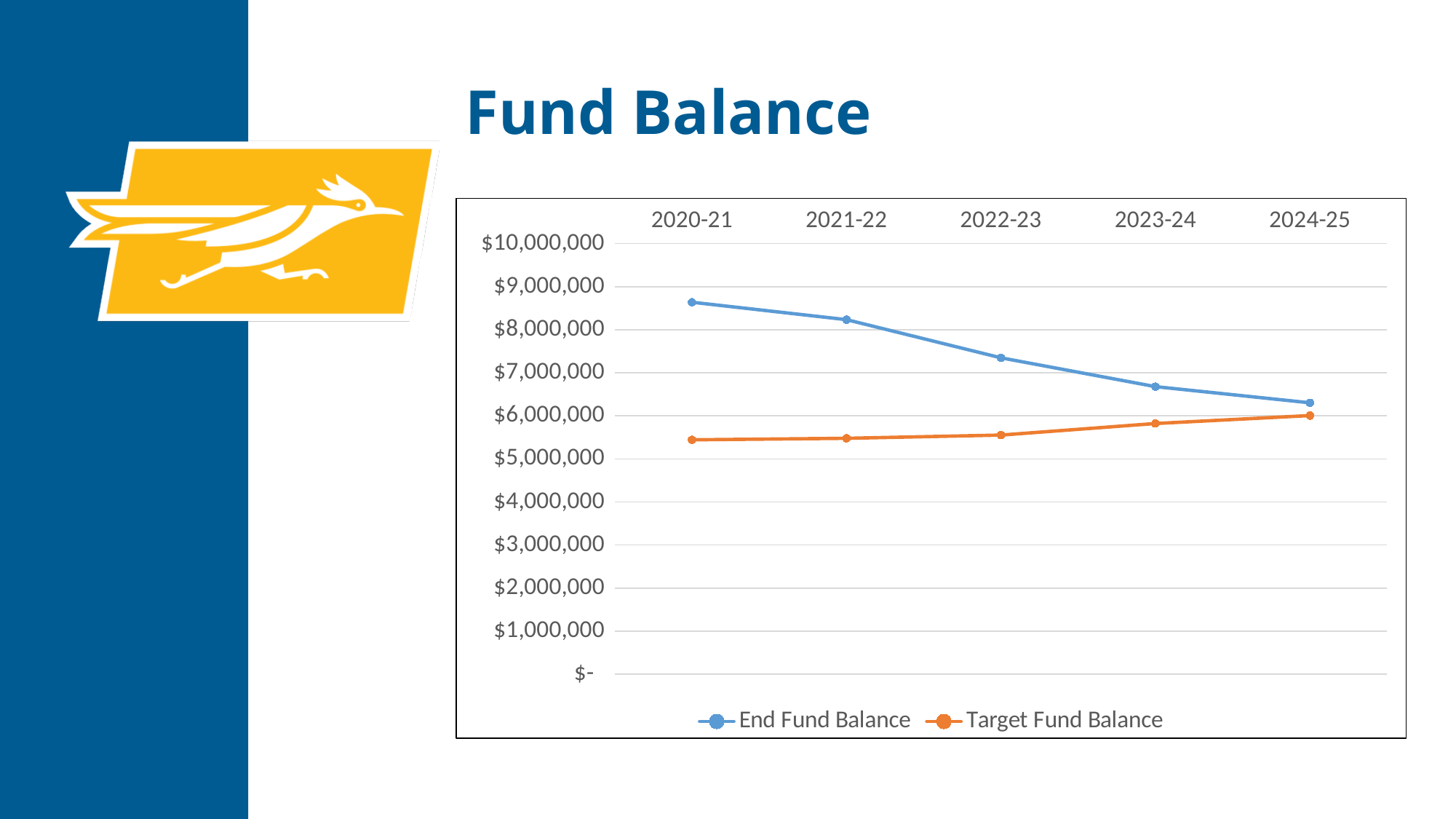
Is the Target Fund Balance for 2020-21 greater or less than $6,000,000? less In which year is the Target Fund Balance highest? 2024-25 Does the End Fund Balance rise or fall from 2020-21 to 2024-25? Fall In which year is the End Fund Balance highest? 2020-21 How many series does the legend list? 2 What kind of chart is shown on the slide? Line chart Does the Target Fund Balance rise or fall from 2020-21 to 2024-25? Rise In which year is the End Fund Balance lowest? 2024-25 In 2020-21, which is larger: the End Fund Balance or the Target Fund Balance? End Fund Balance How many fiscal years are plotted along the x axis? 5 What is the title of the slide containing the chart? Fund Balance Is the End Fund Balance for 2020-21 greater or less than $8,000,000? greater